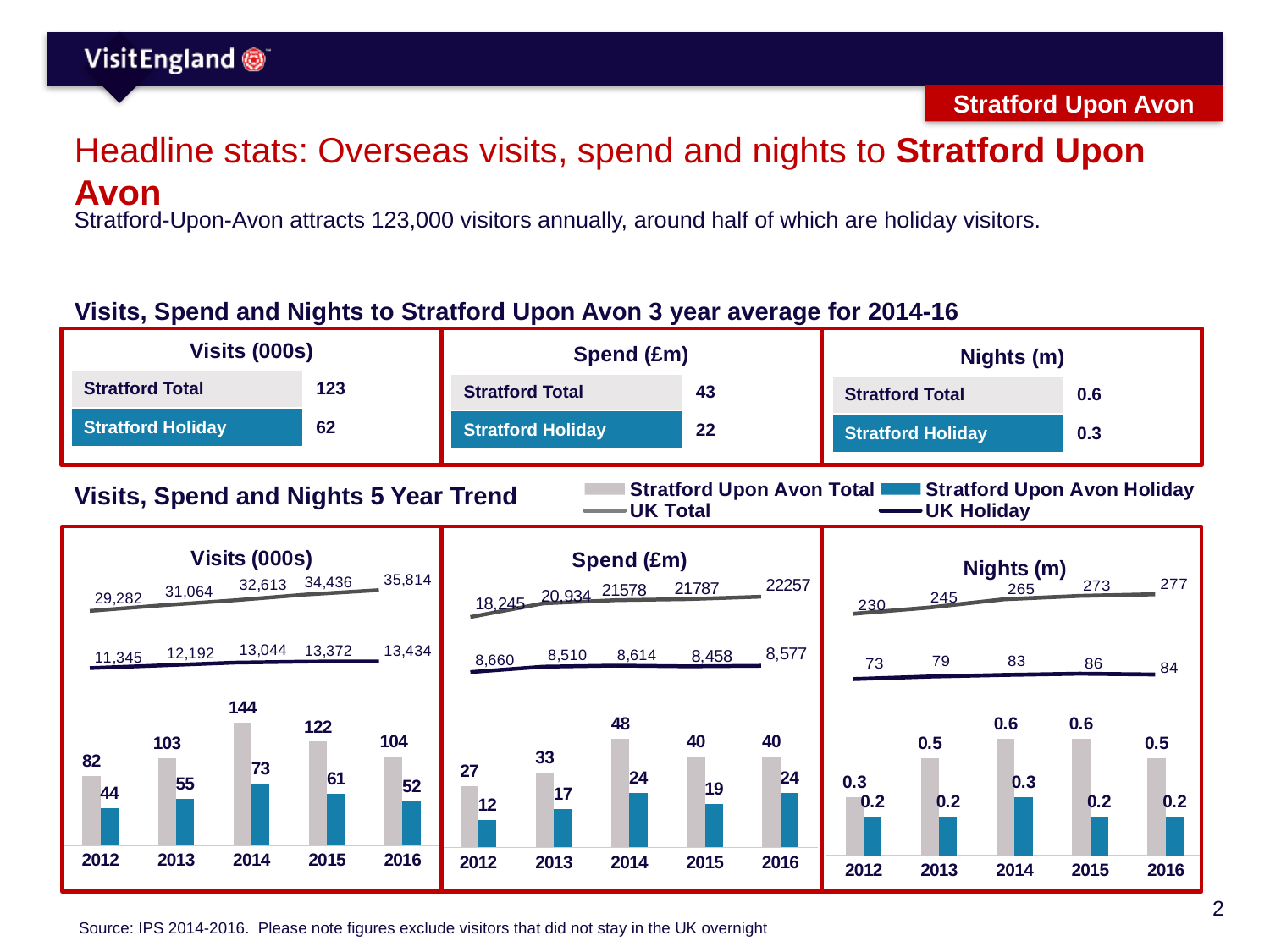
In the Nights (m) chart, what is the Stratford Upon Avon Holiday value for 2014? 0.3 In the Spend (£m) chart, which year has the lowest Stratford Upon Avon Total value? 2012 In the Nights (m) chart, what is the UK Holiday value for 2015? 86 In the Visits (000s) chart, what is the Stratford Upon Avon Total value for 2014? 144 In the Spend (£m) chart, what is the Stratford Upon Avon Holiday value for 2012? 12 In the Visits (000s) chart, is the Stratford Upon Avon Holiday value for 2014 larger or smaller than the value for 2015? larger How many years are shown on the x axis of the Spend (£m) chart? 5 In the Spend (£m) chart, what is the difference between the Stratford Upon Avon Total and Stratford Upon Avon Holiday values in 2014? 24 In the Visits (000s) chart, what is the UK Total value for 2016? 35,814 In the Nights (m) chart, does the UK Total line rise or fall from 2012 to 2016? rise How many series does the legend for the 5 Year Trend charts list? 4 In the Visits (000s) chart, which year has the highest Stratford Upon Avon Total value? 2014